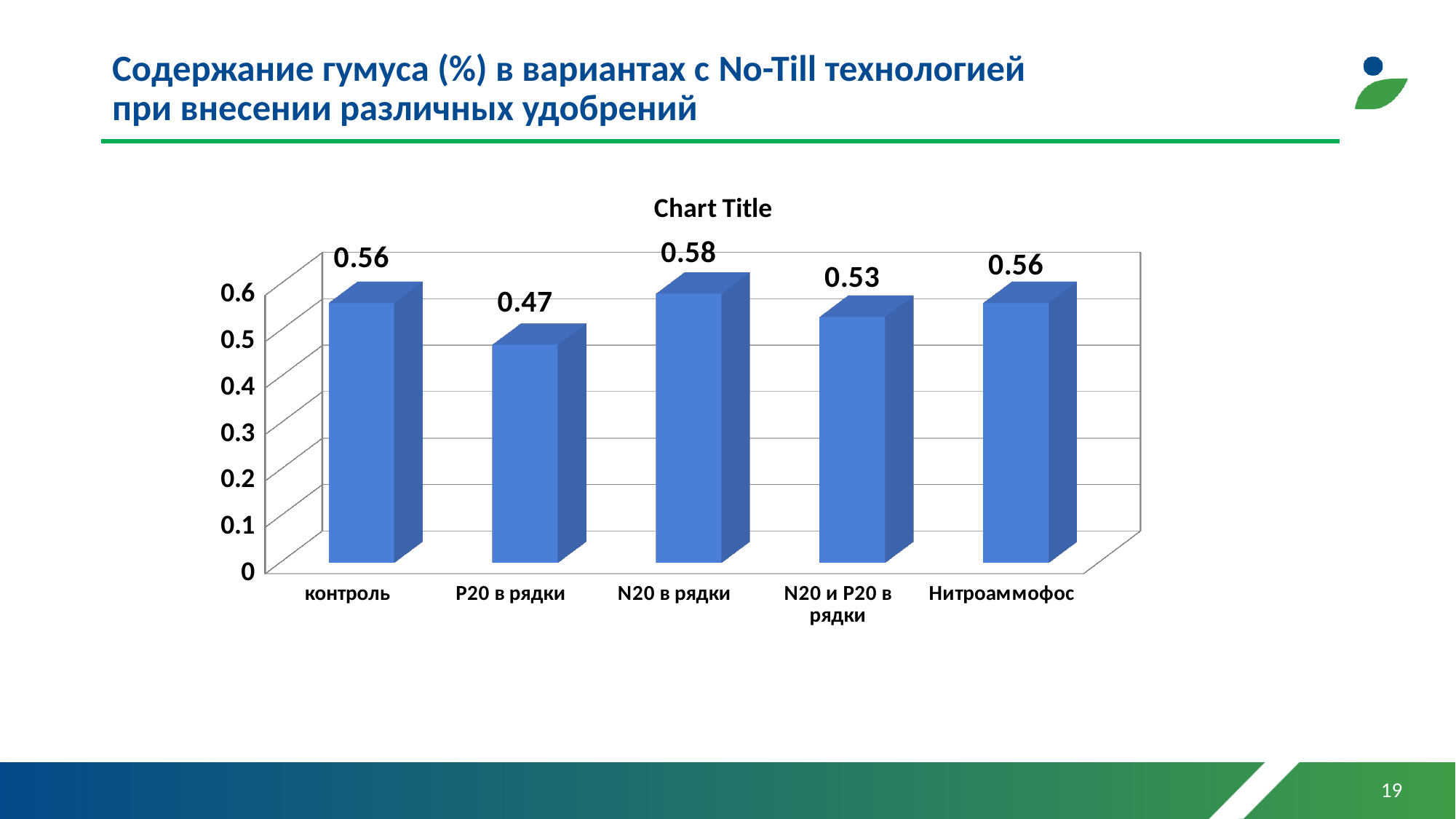
How many categories are shown on the x axis? 5 What is the value for контроль? 0.56 What is the value for N20 в рядки? 0.58 Which category has the highest value? N20 в рядки Is the value for P20 в рядки greater or less than 0.5? less What is the value for P20 в рядки? 0.47 Which is larger, the value for Нитроаммофос or the value for N20 и P20 в рядки? Нитроаммофос What is the difference between the values for N20 в рядки and P20 в рядки? 0.11 What is the value for N20 и P20 в рядки? 0.53 What kind of chart is shown on the slide? bar chart What is the title printed above the chart? Chart Title Which category has the lowest value? P20 в рядки